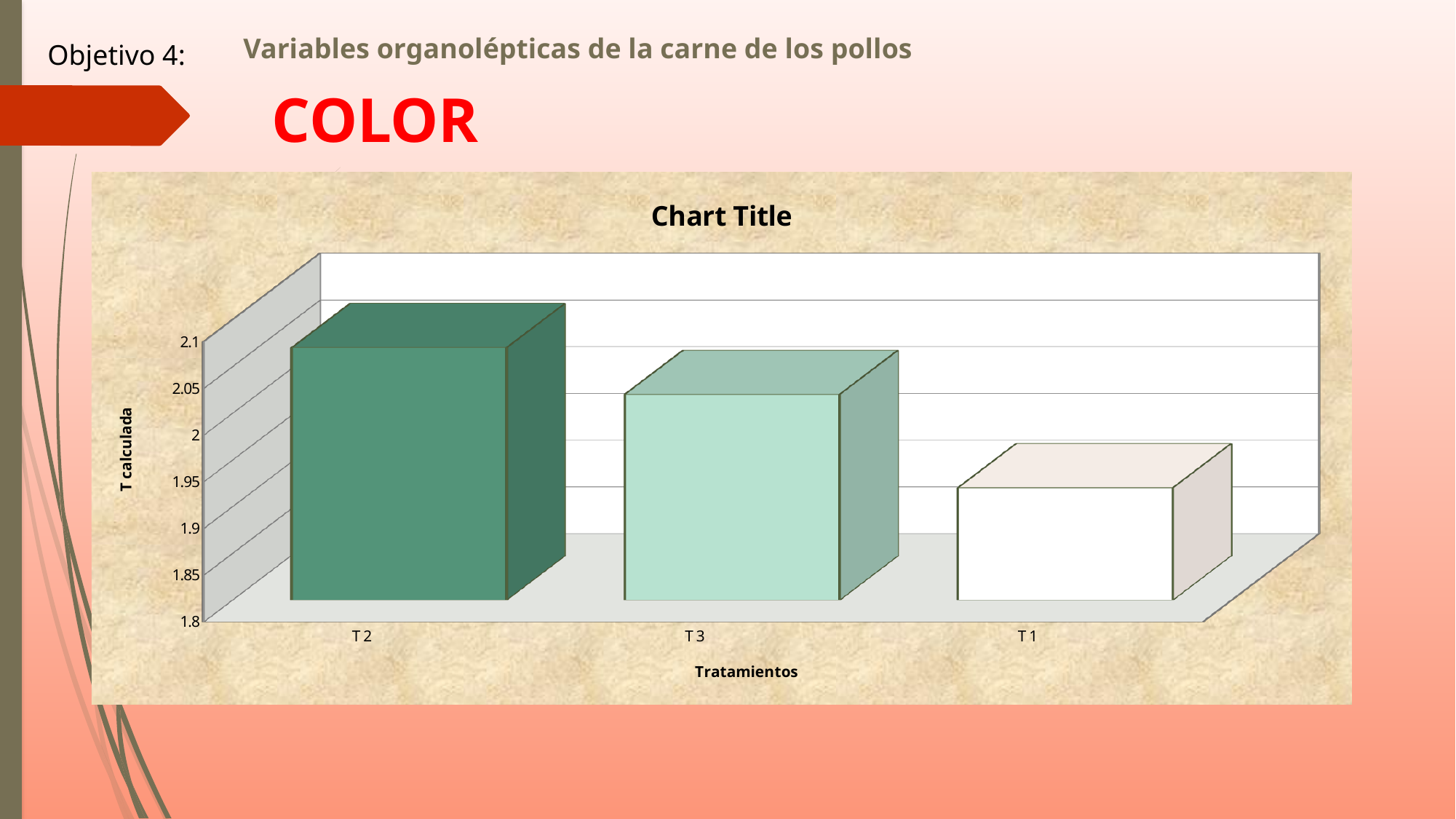
Which treatment has the highest T calculada value? T 2 Which has a larger T calculada value, T 2 or T 3? T 2 What is the title of the y axis? T calculada Is the value for T 2 greater or less than 2? greater Do the bar values rise or fall from left to right along the x axis? fall Is the value for T 3 greater or less than 1.95? greater How many treatment categories are plotted on the x axis? 3 Which has a larger T calculada value, T 3 or T 1? T 3 What is the title of the x axis? Tratamientos Is the value for T 1 greater or less than 2.05? less What kind of chart is shown on the slide? bar chart Which treatment has the lowest T calculada value? T 1